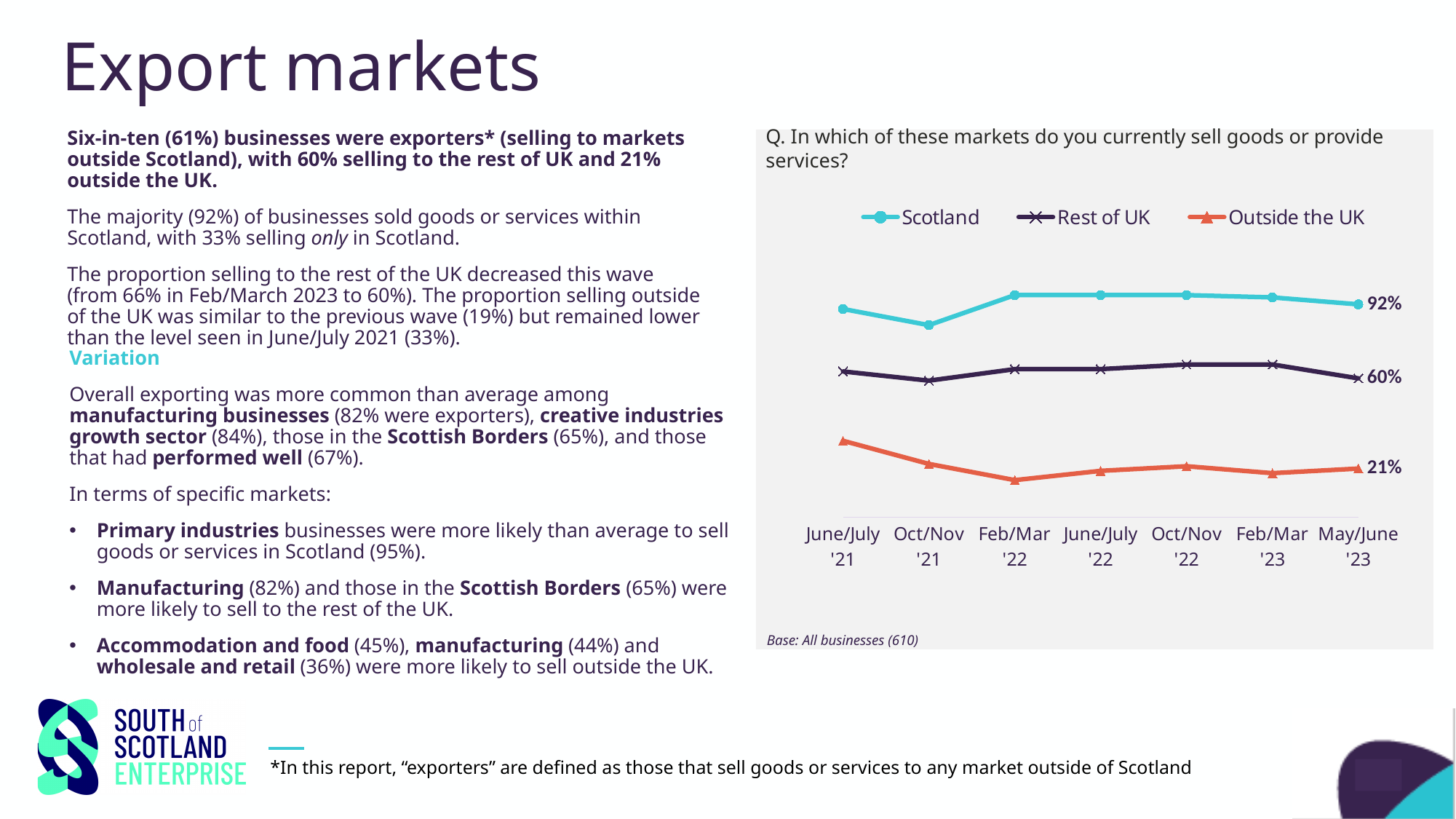
What is the value for Rest of UK at May/June '23? 60% Which series has the lowest value at May/June '23? Outside the UK What is the value for Scotland at May/June '23? 92% At May/June '23, what is the difference between the Rest of UK value and the Outside the UK value? 39 percentage points At May/June '23, what is the difference between the Scotland value and the Rest of UK value? 32 percentage points How many time periods are shown on the x axis? 7 Does the Outside the UK line rise or fall from June/July '21 to Feb/Mar '22? Fall How many series does the legend list? 3 What is the value for Outside the UK at May/June '23? 21% What kind of chart is shown? Line chart Which series has the highest value at May/June '23? Scotland At May/June '23, which is larger: the Rest of UK value or the Outside the UK value? Rest of UK